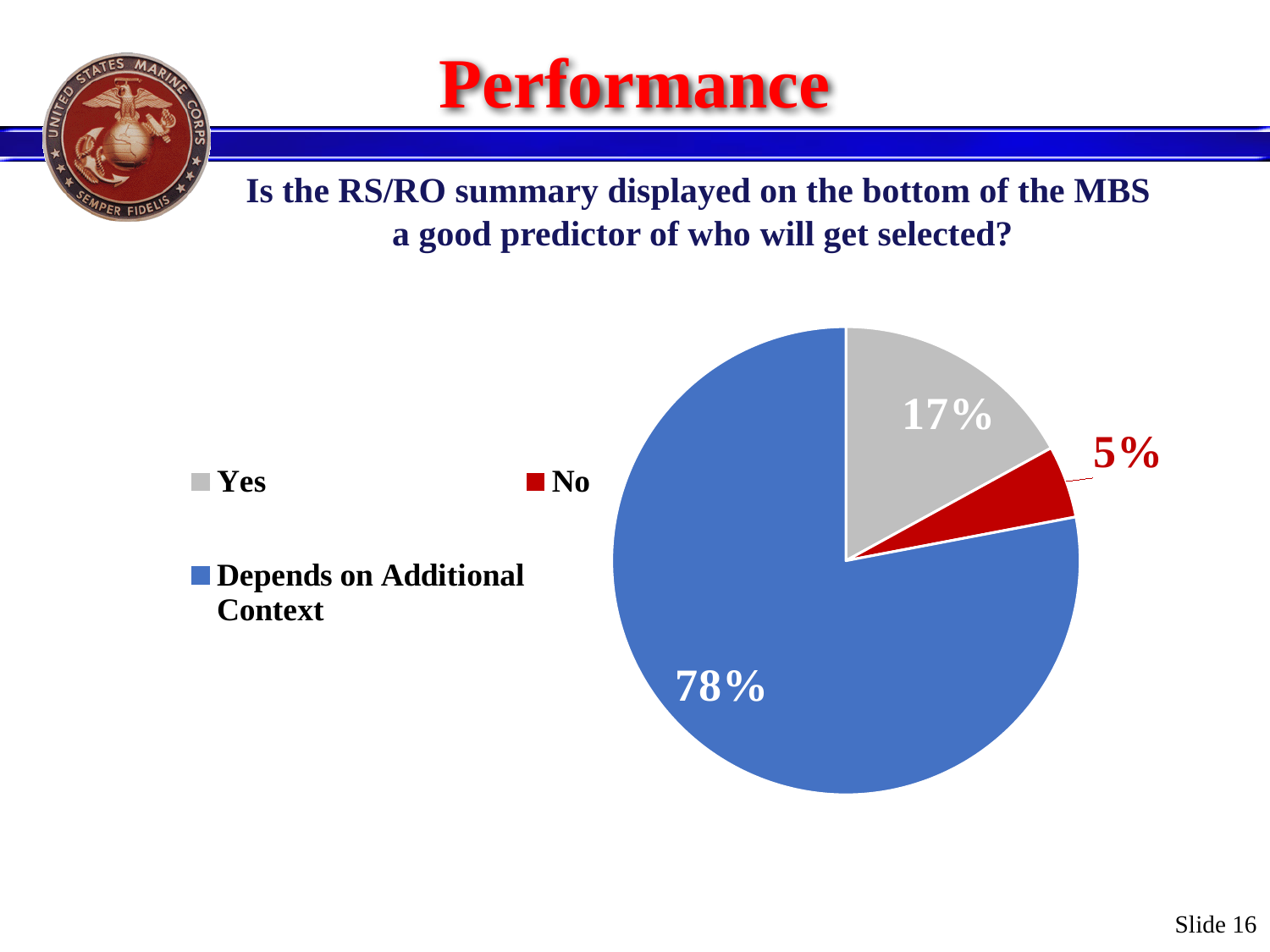
Which response has the smallest share of the pie? No How many entries does the legend list? 3 How many slices does the pie chart have? 3 What percentage of respondents answered "Yes"? 17% What colour is the slice for "No"? red Which response has the largest share of the pie? Depends on Additional Context What percentage of respondents answered "Depends on Additional Context"? 78% What kind of chart is shown on the slide? pie chart How many percentage points larger is the "Yes" share than the "No" share? 12 Which is larger, the share for "Yes" or the share for "No"? Yes How many percentage points larger is the "Depends on Additional Context" share than the "Yes" share? 61 What percentage of respondents answered "No"? 5%